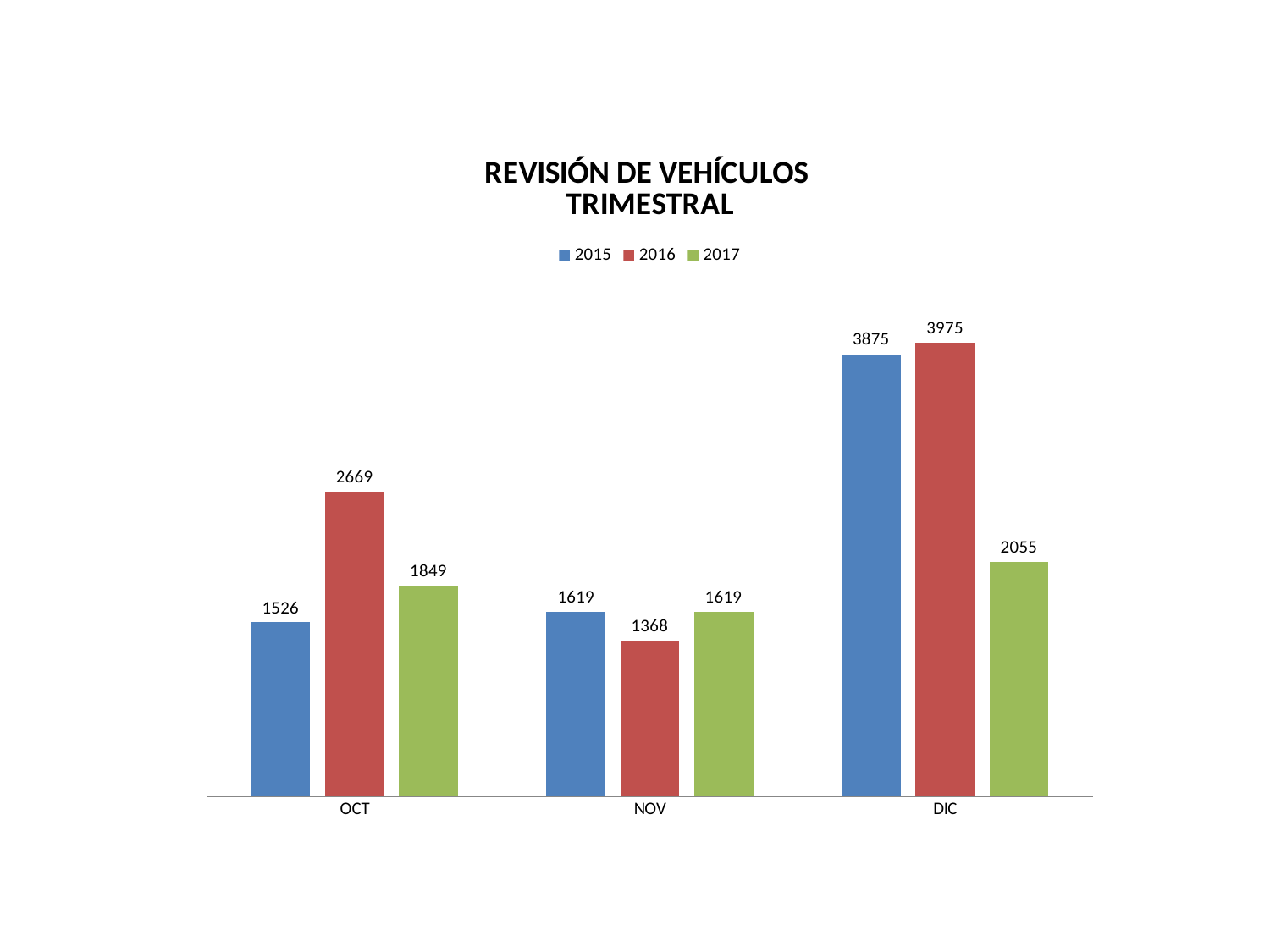
What is the difference between the 2016 and 2017 values in OCT? 820 Which is larger in NOV, the value for 2015 or the value for 2016? 2015 What is the difference between the 2016 and 2015 values in DIC? 100 Which month has the highest value for the 2015 series? DIC What kind of chart is shown on the slide? Bar chart What is the value for 2015 in NOV? 1619 Which month has the lowest value for the 2016 series? NOV What is the value for 2016 in OCT? 2669 What is the title of the chart? REVISIÓN DE VEHÍCULOS TRIMESTRAL How many series does the legend list? 3 What is the value for 2017 in DIC? 2055 How many months are shown on the x axis? 3